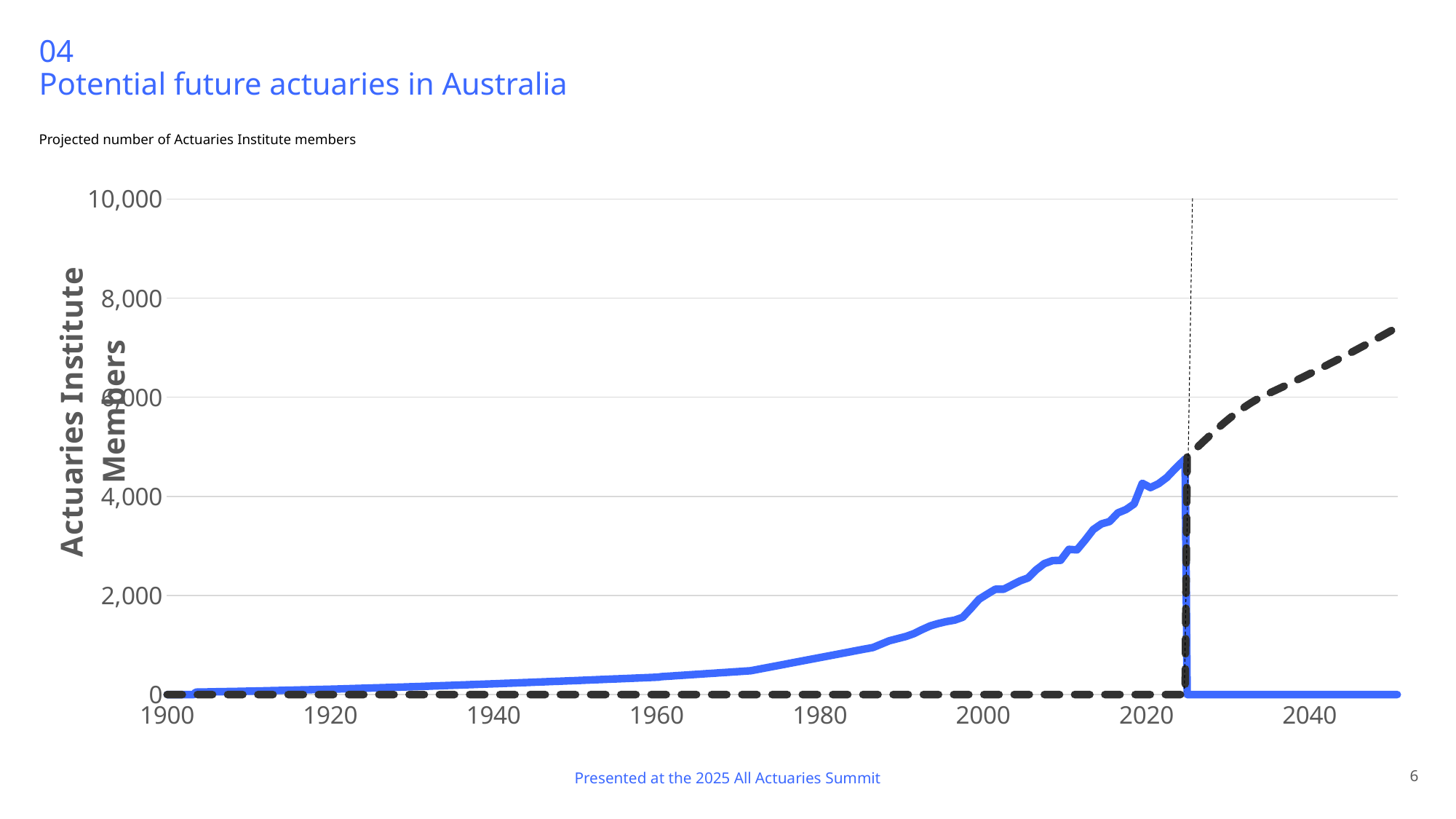
Does the number of Actuaries Institute members rise or fall from 1900 to 2020? rise Is the projected number of members in 2040 greater or less than 6,000? greater What is the highest value shown on the vertical axis? 10,000 Is the number of members in 2010 greater or less than 4,000? less Which is larger, the number of members in 1980 or in 2010? 2010 What kind of chart is shown on the slide? line chart Is the number of members in 1980 greater or less than 2,000? less What is the label on the vertical axis of the chart? Actuaries Institute Members What is the title of the chart? Projected number of Actuaries Institute members Does the projected (dashed) line rise or fall from 2025 to 2050? rise